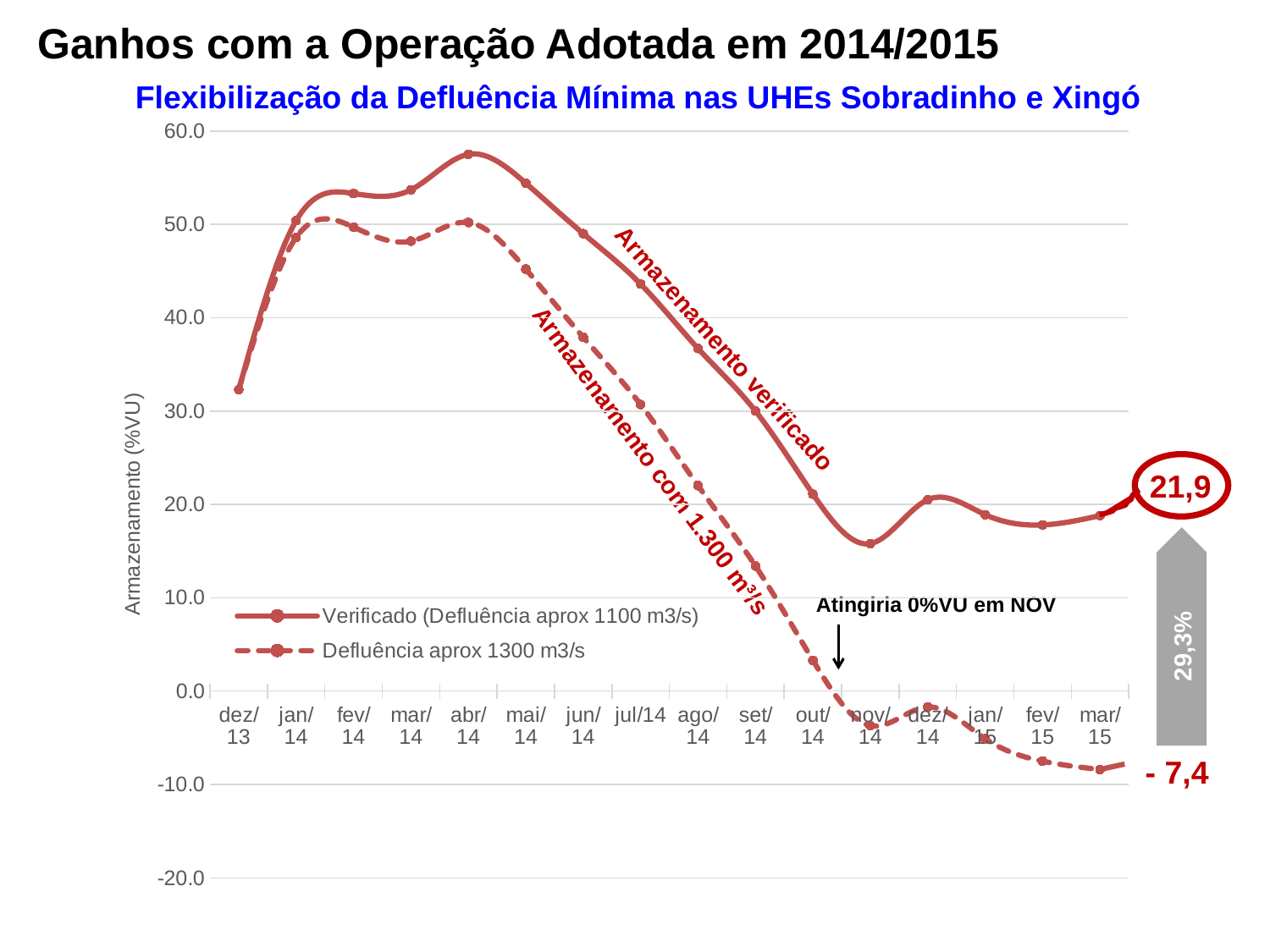
What kind of chart is shown on the slide? line chart In which month does the Verificado series reach its highest value? abr/14 At mar/15, which series has the higher value? Verificado (Defluência aprox 1100 m3/s) Does the Verificado series rise or fall between abr/14 and nov/14? fall Is the value of the Verificado series at dez/13 greater or less than 30? greater How many series does the legend list? 2 What is the label of the vertical axis? Armazenamento (%VU) Is the value of the Defluência aprox 1300 m3/s series at set/14 greater or less than 20? less What is the difference between the two series at mar/15, as printed on the slide? 29,3% How many months are shown along the x axis? 16